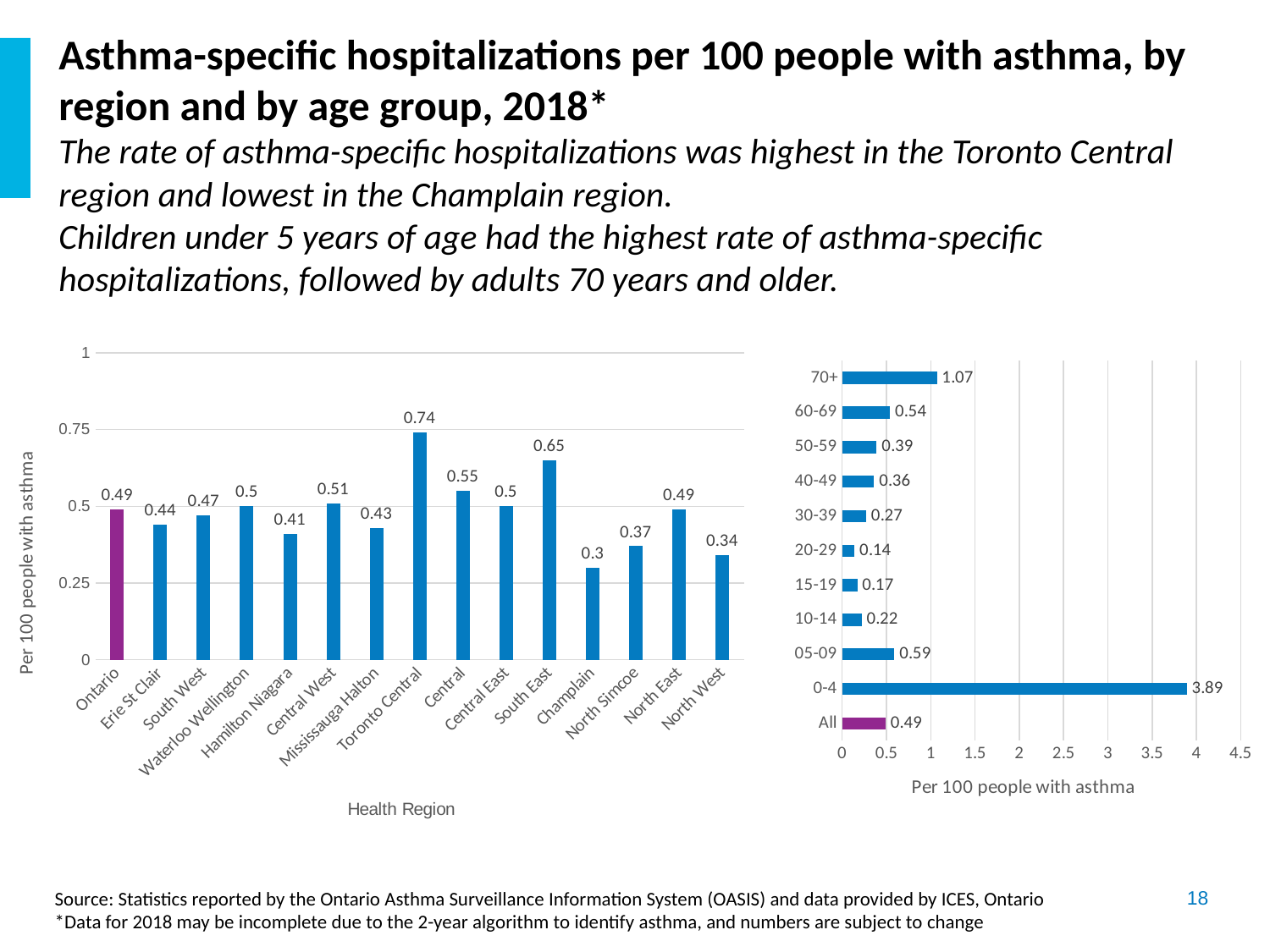
In the left chart (by health region), which health region has the lowest value? Champlain In the left chart (by health region), how many health regions are shown on the x axis? 15 In the left chart (by health region), what is the difference between the values for Toronto Central and Champlain? 0.44 In the left chart (by health region), what is the value for Toronto Central? 0.74 In the right chart (by age group), what is the value for the 0-4 age group? 3.89 In the left chart (by health region), which is larger, the value for South East or the value for Central? South East In the left chart (by health region), what is the label on the x axis? Health Region In the right chart (by age group), how many age-group categories are shown, including All? 11 In the right chart (by age group), what is the difference between the values for 70+ and 60-69? 0.53 In the right chart (by age group), which age group has the lowest value? 20-29 What kind of chart is the right chart (by age group)? Bar chart In the left chart (by health region), what is the value for Ontario? 0.49